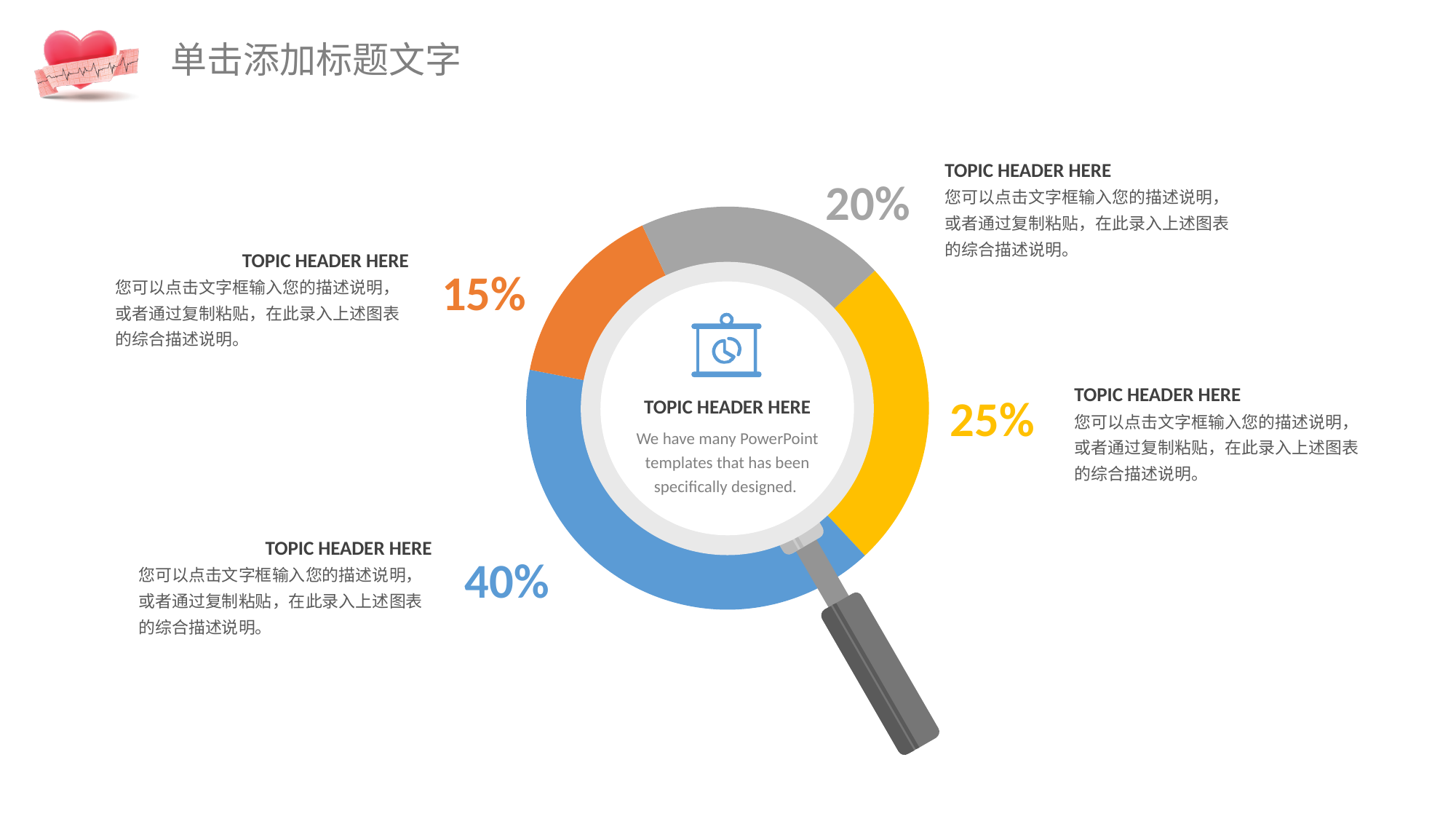
What is the total of the four percentages shown on the donut chart? 100% Which colour segment of the donut chart has the smallest share? Orange Which is larger, the gray segment or the orange segment? Gray How many segments does the donut chart have? 4 What percentage is shown for the blue segment of the donut chart? 40% What colour is the segment labelled 25%? Yellow What percentage is shown for the gray segment of the donut chart? 20% What kind of chart is shown on the slide? Donut chart Which colour segment of the donut chart has the largest share? Blue What percentage is shown for the orange segment of the donut chart? 15% What is the difference between the blue segment's percentage and the yellow segment's percentage? 15% What percentage is shown for the yellow segment of the donut chart? 25%